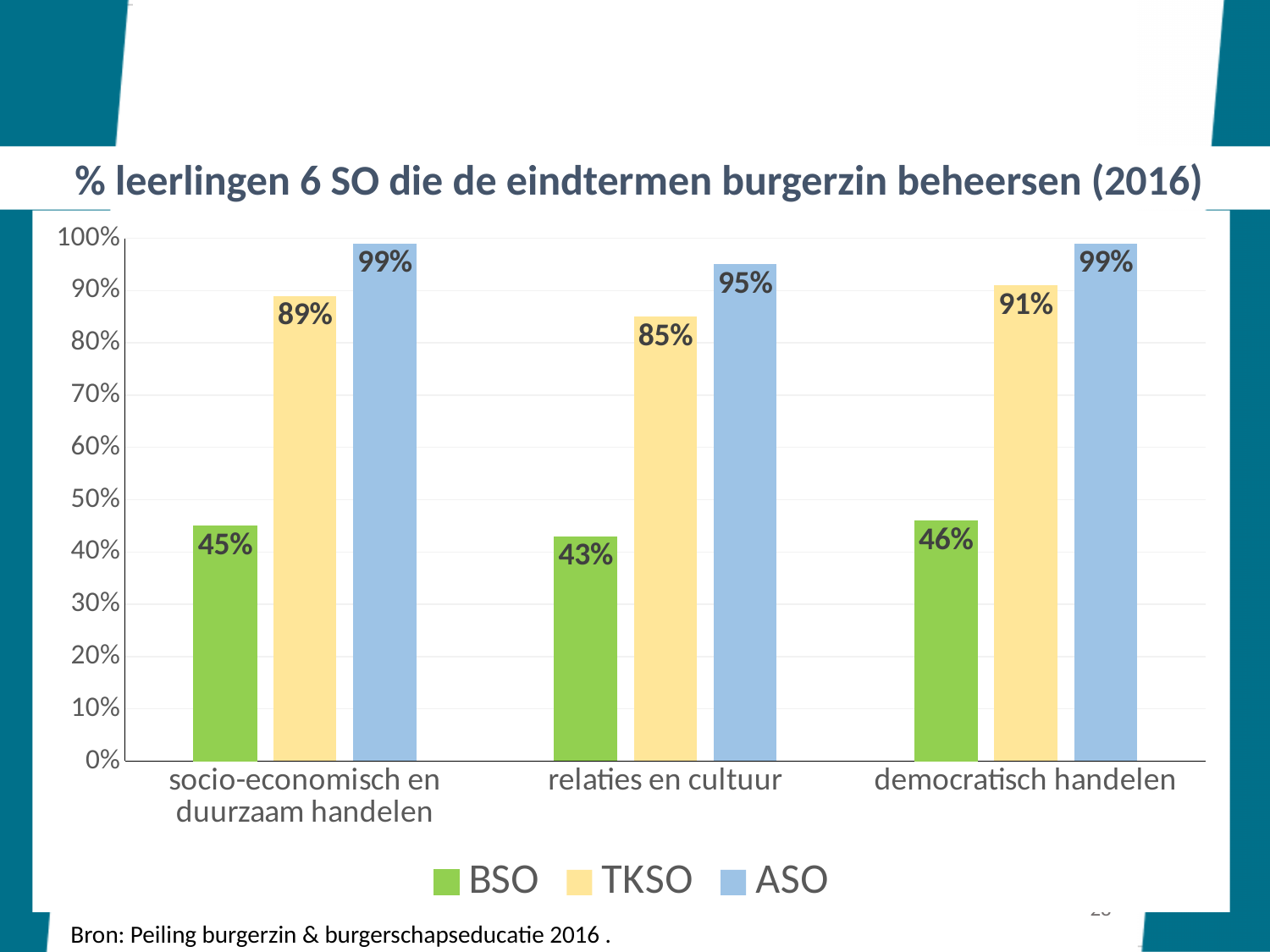
Which is larger: the BSO value for 'democratisch handelen' or the BSO value for 'relaties en cultuur'? democratisch handelen How many series does the legend list? 3 Which series has the lowest value in the 'socio-economisch en duurzaam handelen' category? BSO What is the value for TKSO in the 'democratisch handelen' category? 91% What kind of chart is shown on the slide? bar chart How many categories are shown on the x axis? 3 What is the difference between the TKSO values for 'democratisch handelen' and 'relaties en cultuur'? 6% What is the difference between the ASO and BSO values in the 'socio-economisch en duurzaam handelen' category? 54% What is the value for BSO in the 'relaties en cultuur' category? 43% What is the value for ASO in the 'relaties en cultuur' category? 95% Which category has the highest value for TKSO? democratisch handelen What is the title of the chart? % leerlingen 6 SO die de eindtermen burgerzin beheersen (2016)